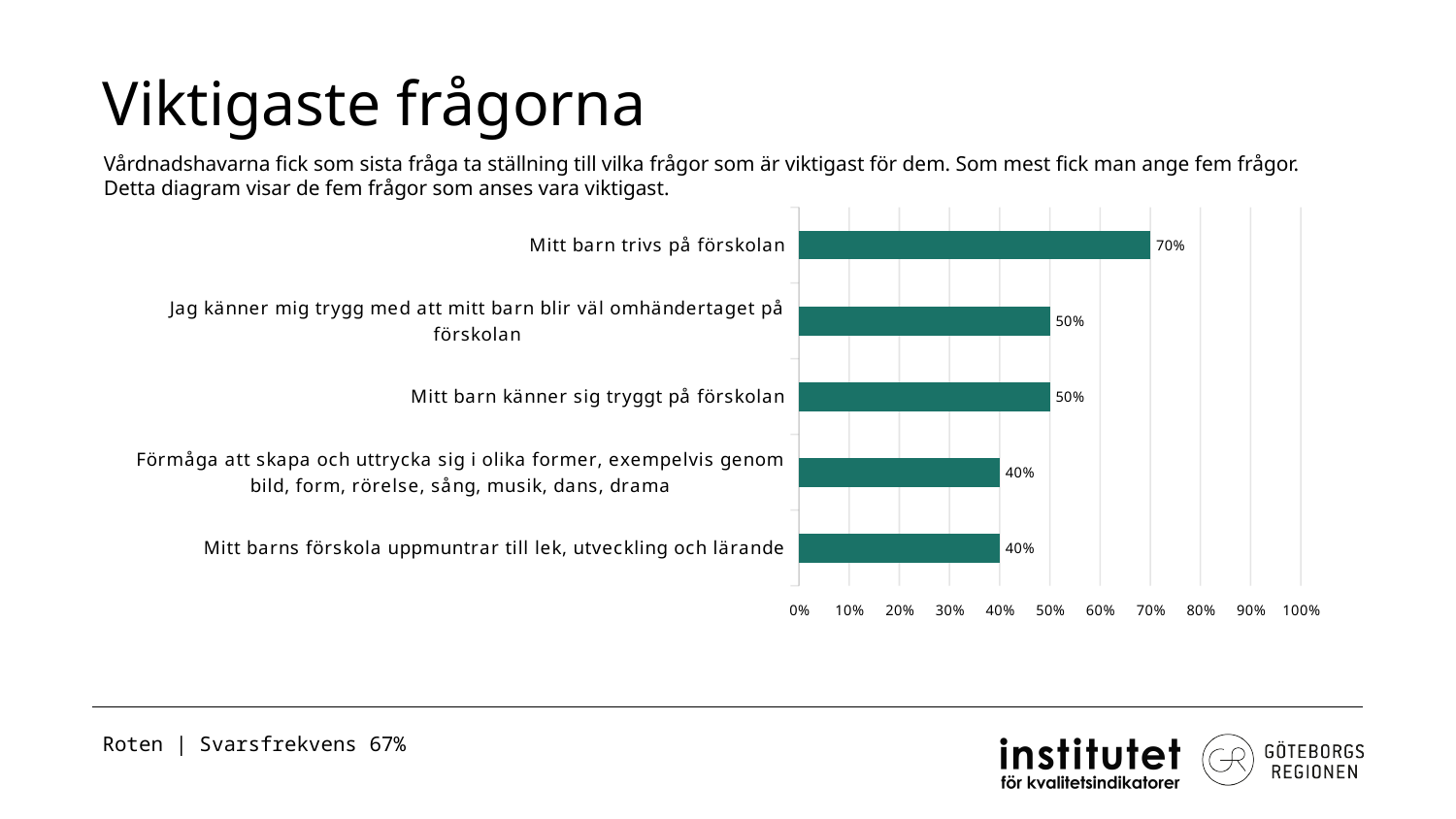
How many categories are shown in the chart? 5 What is the value for "Jag känner mig trygg med att mitt barn blir väl omhändertaget på förskolan"? 50% What is the value for "Mitt barns förskola uppmuntrar till lek, utveckling och lärande"? 40% What is the maximum value shown on the x axis? 100% Which is larger: "Mitt barn känner sig tryggt på förskolan" or "Förmåga att skapa och uttrycka sig i olika former, exempelvis genom bild, form, rörelse, sång, musik, dans, drama"? Mitt barn känner sig tryggt på förskolan Which category has the highest value? Mitt barn trivs på förskolan What is the value for "Mitt barn trivs på förskolan"? 70% What kind of chart is shown on the slide? bar chart What is the difference between "Mitt barn trivs på förskolan" and "Mitt barn känner sig tryggt på förskolan"? 20% What is the title of the slide? Viktigaste frågorna Is the value for "Mitt barn trivs på förskolan" greater or less than 60%? greater What is the difference between "Mitt barn trivs på förskolan" and "Mitt barns förskola uppmuntrar till lek, utveckling och lärande"? 30%